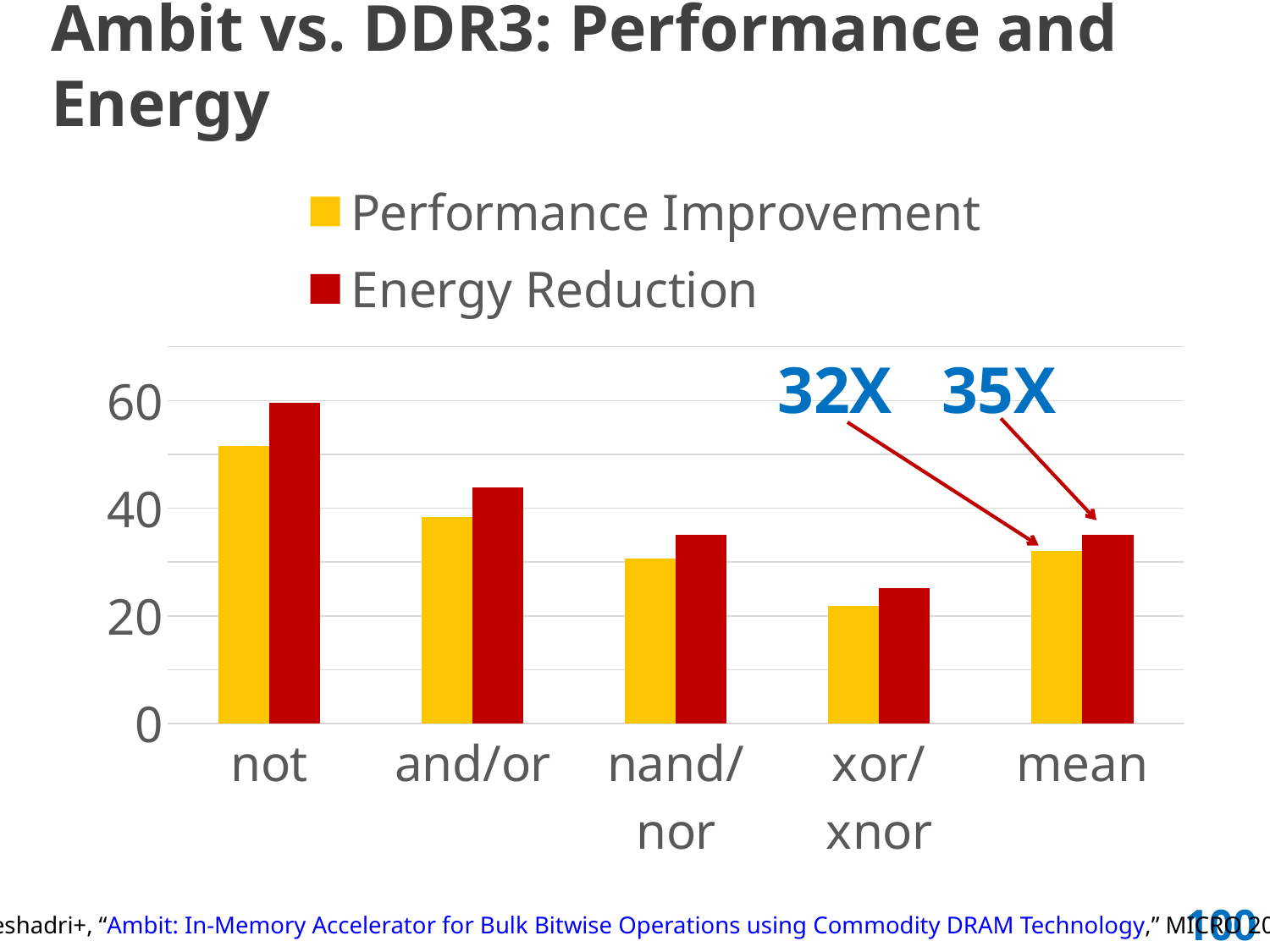
What is the Energy Reduction value for the mean category? 35X Is the Performance Improvement value for not greater or less than 40? greater What is the difference between the Energy Reduction and Performance Improvement values for the mean category? 3X Which category has the highest Performance Improvement? not Is the Energy Reduction value for xor/xnor greater or less than 40? less How many categories are shown on the x axis? 5 For the not category, which is larger: Performance Improvement or Energy Reduction? Energy Reduction How many series does the legend list? 2 Which category has the lowest Energy Reduction? xor/xnor What is the Performance Improvement value for the mean category? 32X What kind of chart is shown on the slide? bar chart Do the Performance Improvement values rise or fall from not to xor/xnor? fall